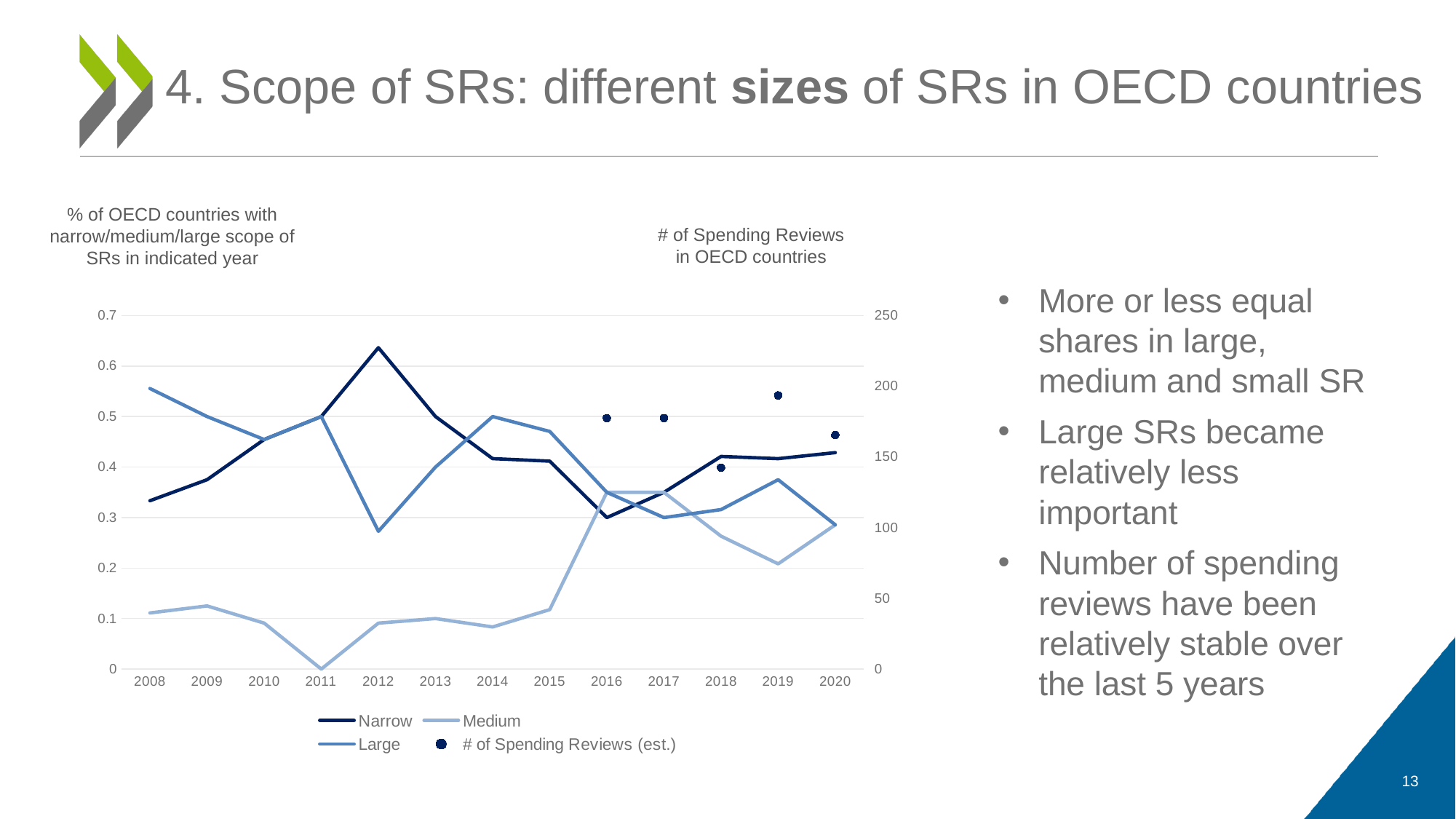
In which year does the Narrow series reach its highest value? 2012 What is the value of the Large series in 2011? 0.5 In which year does the Large series reach its highest value? 2008 How many years are shown on the x axis of the chart? 13 What kind of chart is shown on the slide? line chart How many series does the chart legend list? 4 What is the value of the Medium series in 2011? 0 In which year does the Medium series reach its lowest value? 2011 Is the value of the Narrow series in 2012 greater or less than 0.6? greater In 2008, which series has the larger value, Large or Narrow? Large Is the # of Spending Reviews (est.) value in 2019 greater or less than 150? greater Does the Large series rise or fall from 2008 to 2011? fall